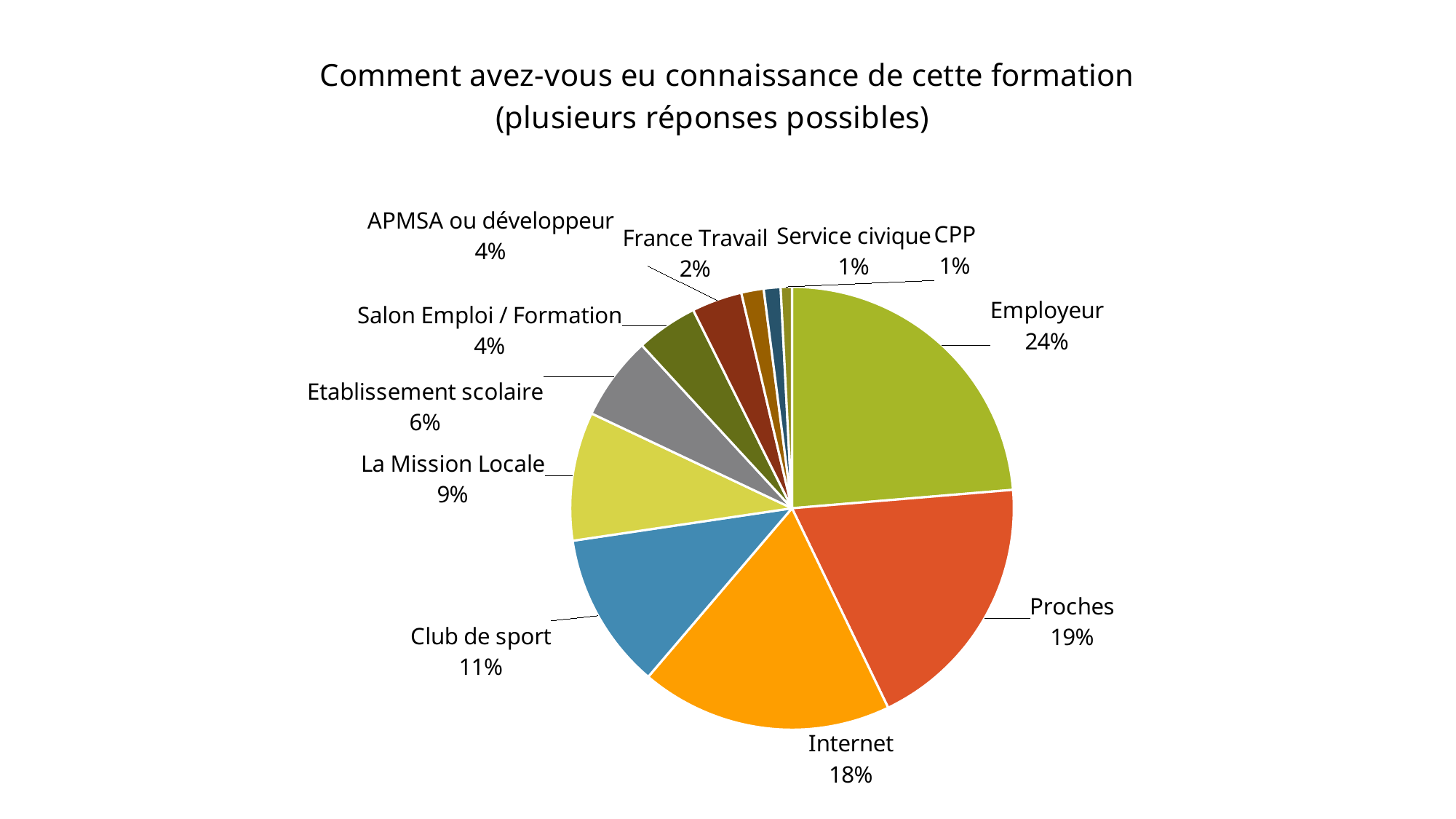
Which is larger, La Mission Locale or Etablissement scolaire? La Mission Locale Which category has the largest slice of the pie? Employeur What is the combined share of Employeur and Proches? 43% What kind of chart is shown on the slide? Pie chart What is the value shown for Internet? 18% What share of the pie does Employeur represent? 24% What is the title of the chart? Comment avez-vous eu connaissance de cette formation (plusieurs réponses possibles) What is the value shown for Club de sport? 11% What is the value shown for Salon Emploi / Formation? 4% What is the value shown for France Travail? 2% How many categories are shown in the pie chart? 11 What is the difference between the Proches and Internet shares? 1%